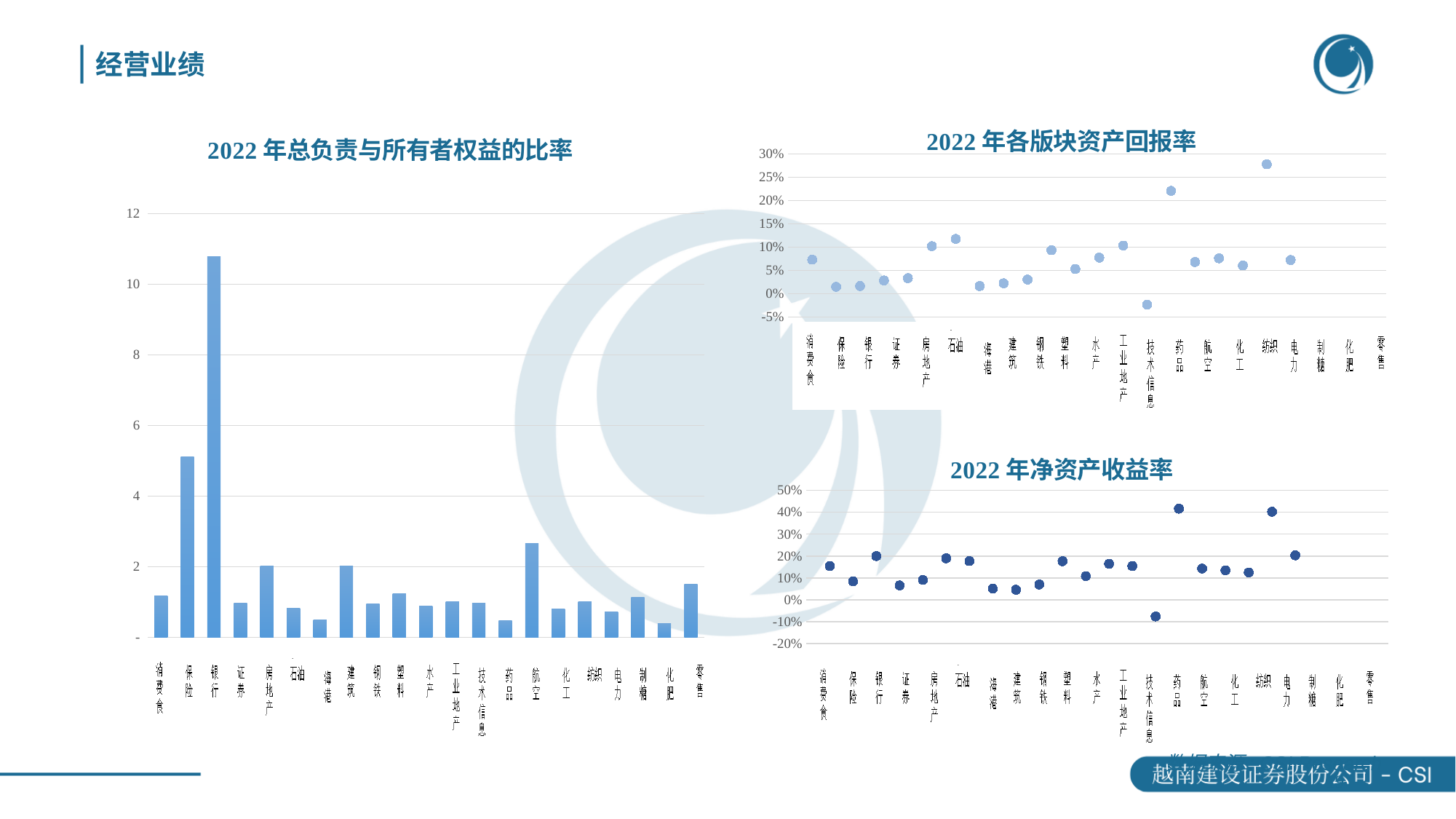
In the chart 2022 年净资产收益率, is the value for 银行 greater or less than 10%? greater In the chart 2022 年净资产收益率, is the value for 消费食 greater or less than 10%? greater What kind of chart is the left chart titled 2022 年总负责与所有者权益的比率? bar chart How many charts are shown on the slide? 3 In the chart 2022 年总负责与所有者权益的比率, is the value for 保险 greater or less than 4? greater In the chart 2022 年总负责与所有者权益的比率, which is larger, the value for 保险 or the value for 航空? 保险 How many categories are shown on the x axis of the chart 2022 年总负责与所有者权益的比率? 21 In the chart 2022 年总负责与所有者权益的比率, which category has the highest value? 银行 What kind of chart is the top-right chart titled 2022 年各版块资产回报率? scatter chart